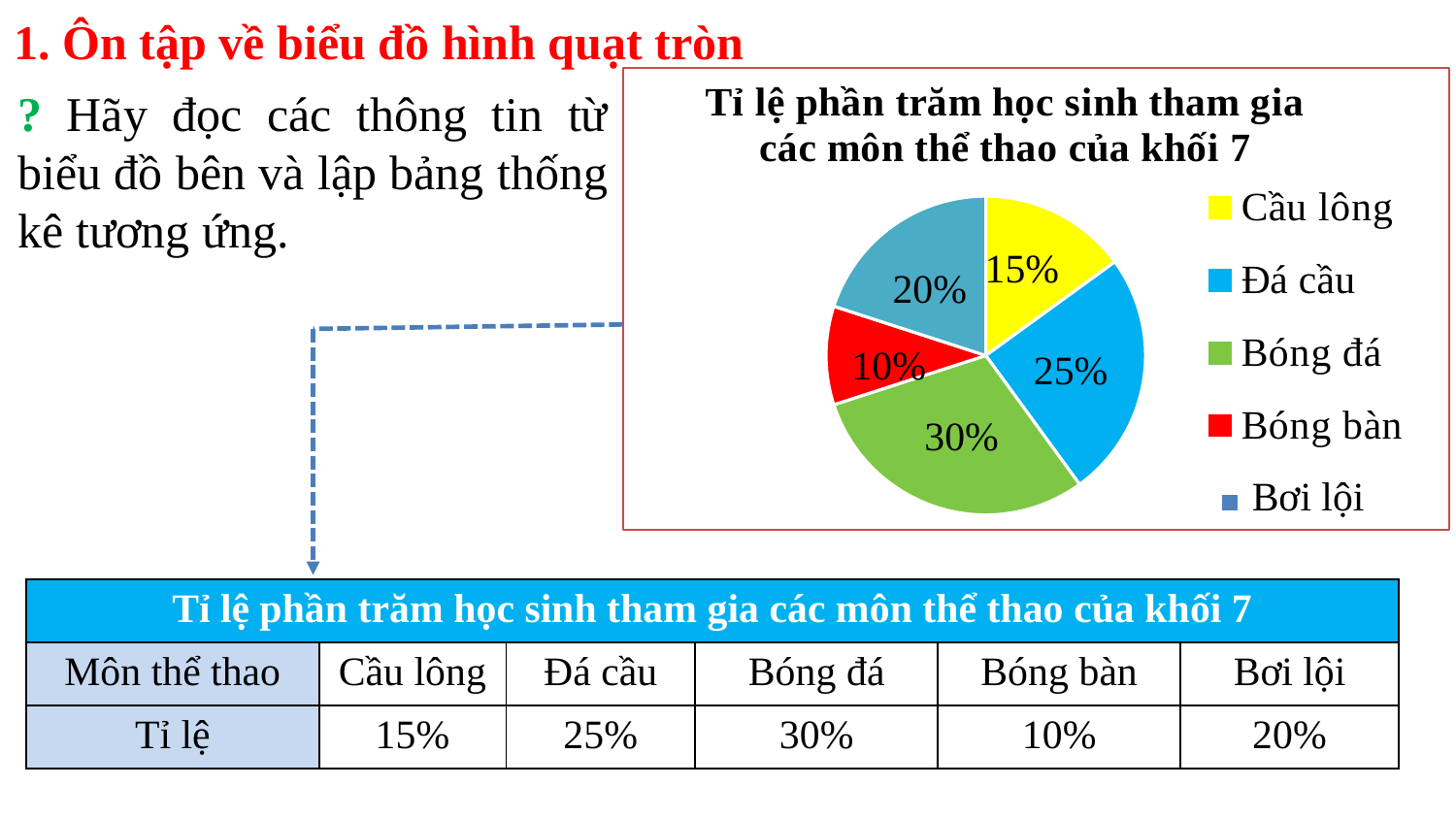
How many sports (slices) are shown in the pie chart? 5 Which sport has the smallest share in the pie chart? Bóng bàn What percentage does the pie chart show for Bơi lội? 20% What kind of chart is shown on the slide? Pie chart What percentage of students take part in Bóng đá according to the pie chart? 30% Which sport has the largest share in the pie chart? Bóng đá What is the value shown for Cầu lông in the pie chart? 15% What is the value for Bóng bàn in the pie chart? 10% What is the title of the pie chart? Tỉ lệ phần trăm học sinh tham gia các môn thể thao của khối 7 Which colour represents Bóng bàn in the pie chart? Red What is the difference between the shares of Đá cầu and Cầu lông? 10% Which has a larger share, Bơi lội or Đá cầu? Đá cầu